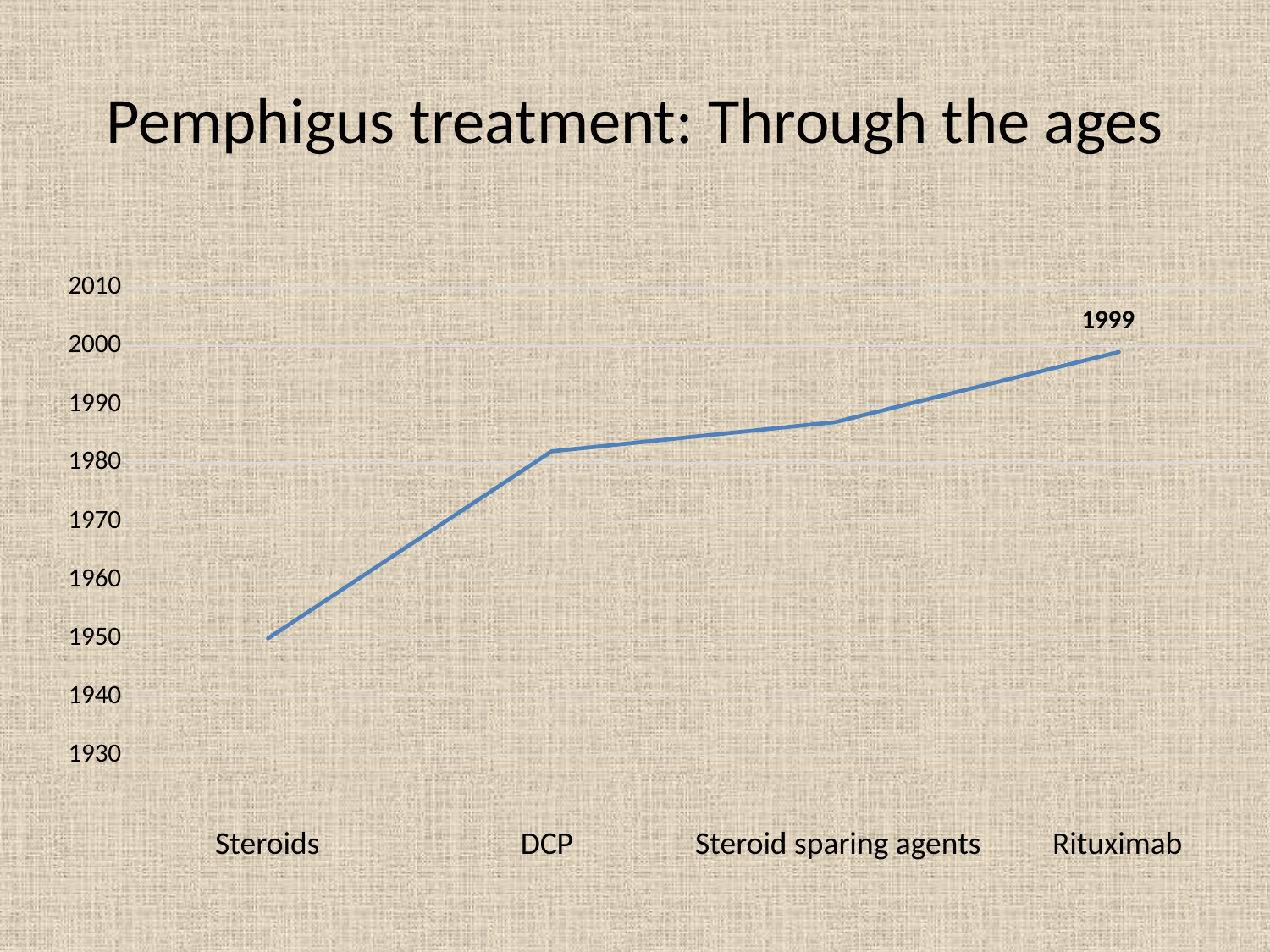
What is the title of the slide? Pemphigus treatment: Through the ages Which has the larger value, DCP or Steroids? DCP Which category has the highest value? Rituximab Which category is the first one on the x axis? Steroids How many categories are plotted along the x axis? 4 Which category has the lowest value? Steroids What kind of chart is shown on the slide? line chart Is the value for DCP greater or less than 1980? greater What value is labelled for Rituximab on the chart? 1999 Is the value for Steroid sparing agents greater or less than 1990? less Do the values rise or fall from Steroids to Rituximab along the x axis? rise Is the value for Steroids greater or less than 1960? less